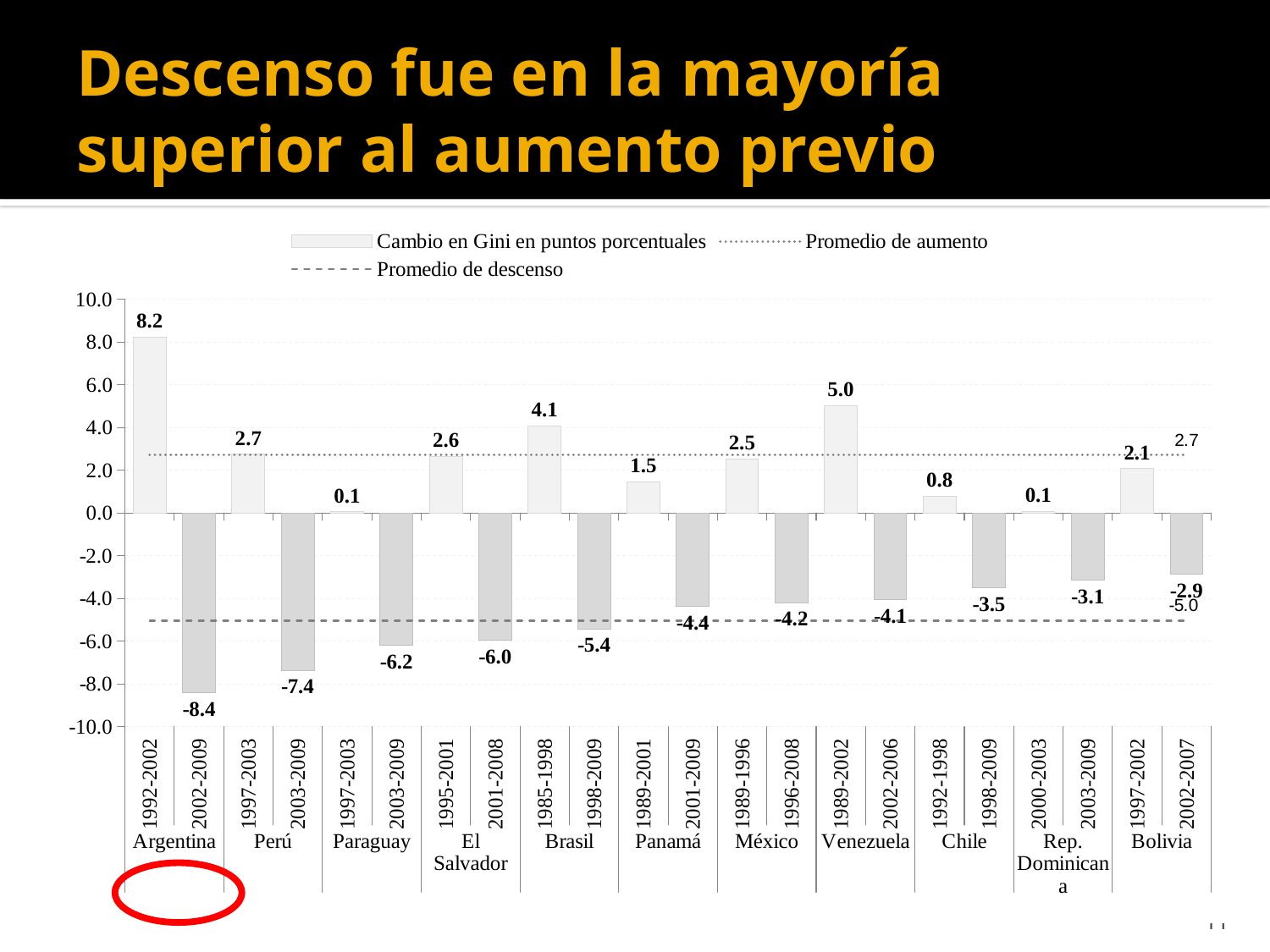
How many countries are shown on the x axis? 11 What kind of chart is shown on the slide? bar chart What is the change in Gini for Argentina in 1992-2002? 8.2 What is the difference between the Gini change for Perú in 1997-2003 and Perú in 2003-2009? 10.1 Which is larger, the Gini change for Brasil in 1985-1998 or for México in 1989-1996? Brasil 1985-1998 Is the value for Chile 1998-2009 greater or less than -2.0? less What value is shown for the 'Promedio de aumento' line? 2.7 How many entries does the legend list? 3 What is the change in Gini for Venezuela in 1989-2002? 5.0 Which bar shows the largest increase in Gini? Argentina 1992-2002 What is the change in Gini for Brasil in 1998-2009? -5.4 Which bar shows the largest decrease in Gini? Argentina 2002-2009